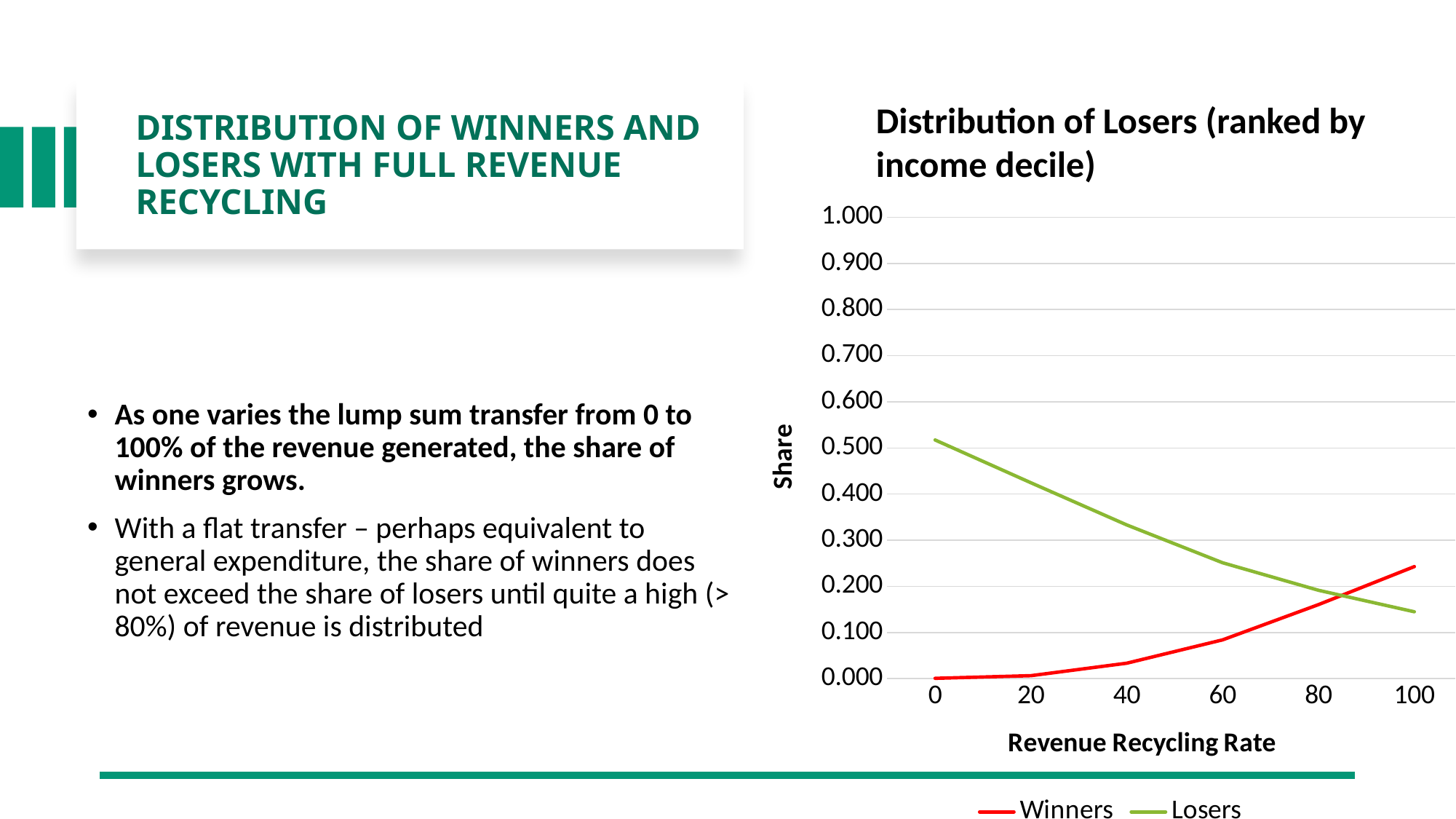
How many revenue recycling rate values are marked on the x axis? 6 At a revenue recycling rate of 0, which series has the larger share, Winners or Losers? Losers Is the Losers share at a revenue recycling rate of 100 greater or less than 0.200? less Is the Winners share at a revenue recycling rate of 100 greater or less than 0.200? greater How many series does the chart legend list? 2 At a revenue recycling rate of 100, which series has the larger share, Winners or Losers? Winners Does the Losers line rise or fall as the revenue recycling rate increases? fall What is the label of the x axis? Revenue Recycling Rate What are the names of the two series in the legend? Winners and Losers Does the Winners line rise or fall as the revenue recycling rate increases? rise What kind of chart is shown on the slide? line chart Is the Losers share at a revenue recycling rate of 0 greater or less than 0.400? greater